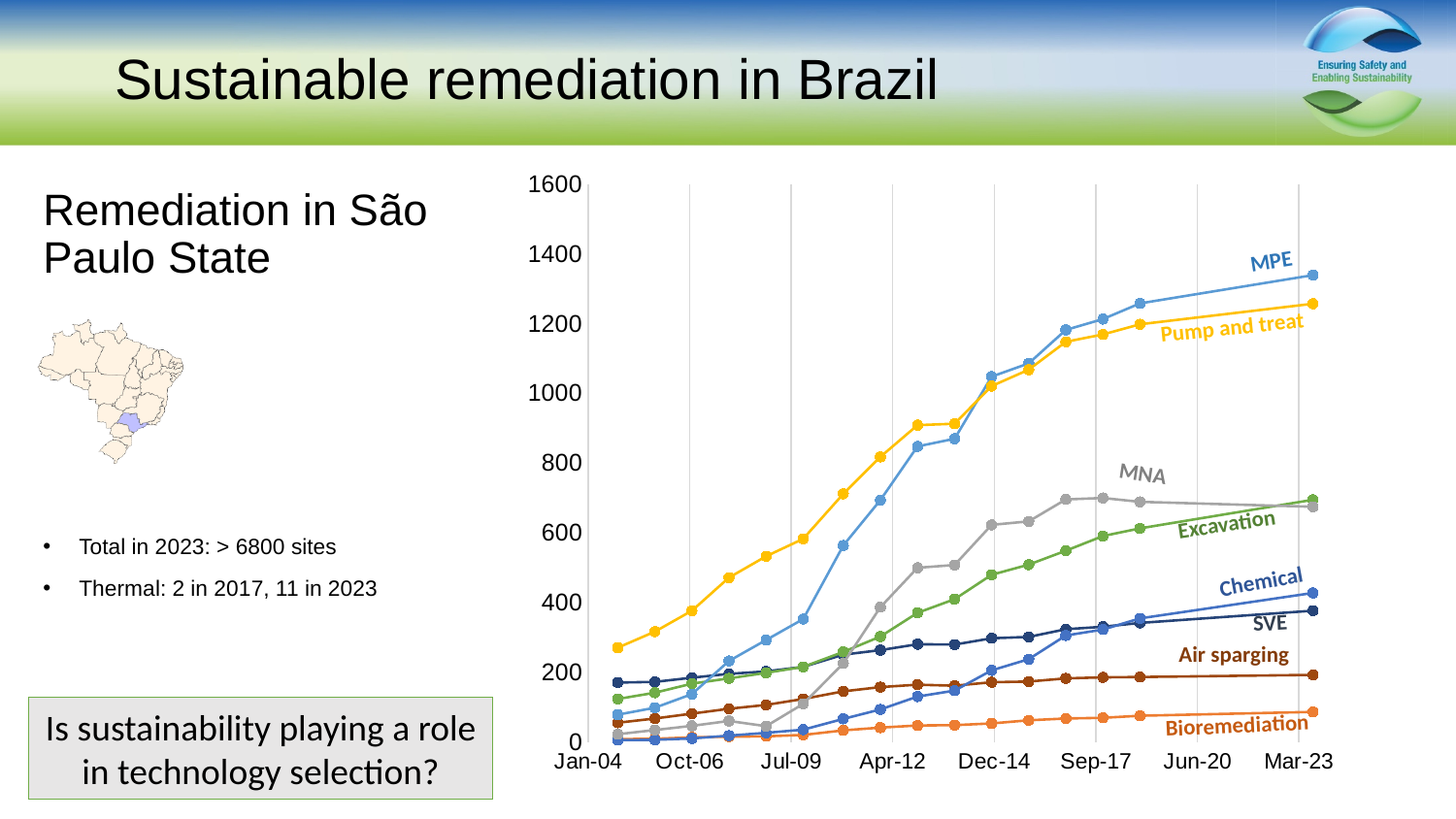
Is the value for Bioremediation at Mar-23 greater or less than 200? less Which series has a larger value at Jan-04, Pump and treat or MPE? Pump and treat Which series has the lowest value at Mar-23? Bioremediation Does the MPE series generally rise or fall from Jan-04 to Mar-23? rise Is the value for MNA at Mar-23 greater or less than 600? greater Which series has a larger value at Mar-23, Chemical or Air sparging? Chemical How many series are labelled on the chart? 8 What kind of chart is shown on the slide? line chart What is the first date label on the x axis? Jan-04 Is the value for Pump and treat at Jan-04 greater or less than 400? less Which series has the highest value at Mar-23? MPE